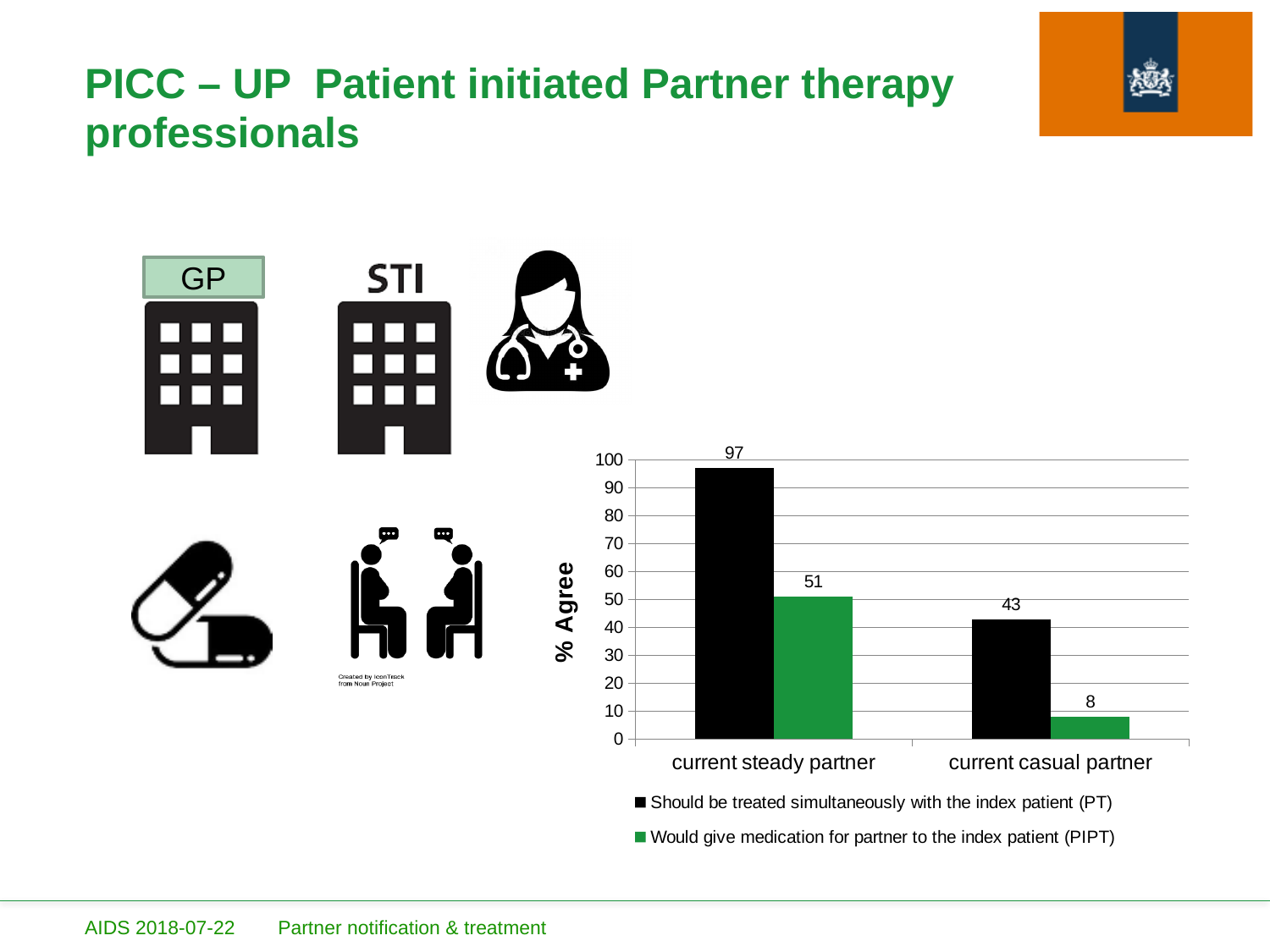
Which bar in the chart has the highest value? Should be treated simultaneously with the index patient (PT), current steady partner Which bar in the chart has the lowest value? Would give medication for partner to the index patient (PIPT), current casual partner What type of chart is shown on the slide? Bar chart How many categories are shown on the x axis of the chart? 2 What is the value for 'Would give medication for partner to the index patient (PIPT)' for current casual partner? 8 What is the difference between the PT and PIPT values for current steady partner? 46 Which is larger: the PIPT value for current steady partner or the PT value for current casual partner? PIPT value for current steady partner What is the value for 'Should be treated simultaneously with the index patient (PT)' for current casual partner? 43 What is the value for 'Should be treated simultaneously with the index patient (PT)' for current steady partner? 97 What is the difference between the PT values for current steady partner and current casual partner? 54 How many series does the chart's legend list? 2 What is the value for 'Would give medication for partner to the index patient (PIPT)' for current steady partner? 51